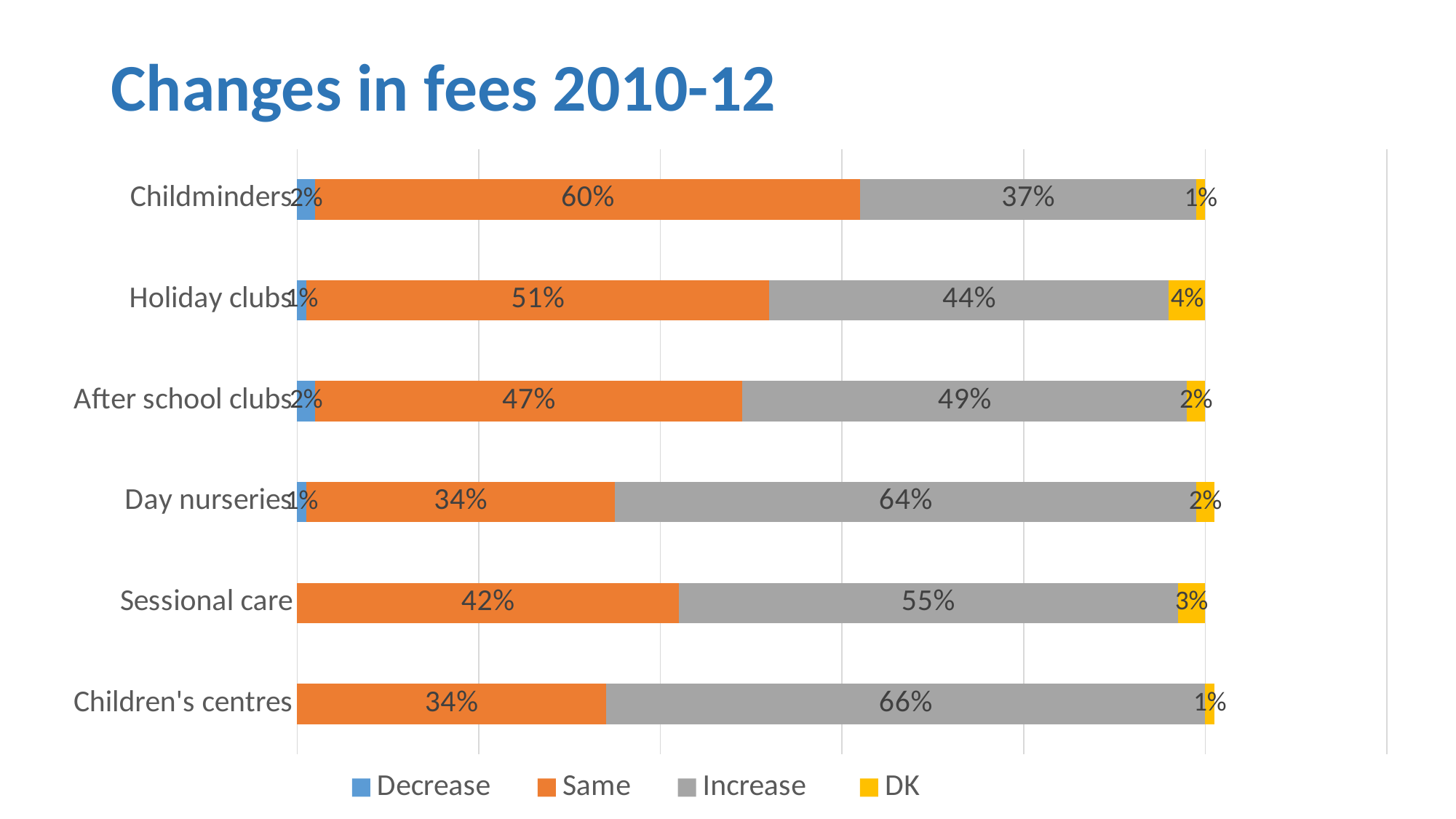
How many series does the legend list? 4 What is the total of the stacked bar for Childminders? 100% How many categories are shown on the chart? 6 What kind of chart is shown on the slide? Stacked bar chart What is the difference between the 'Increase' values for Children's centres and Childminders? 29% Which category has the highest 'Increase' value? Children's centres Which category has the lowest 'Same' value? Day nurseries and Children's centres (34%) Which is larger for After school clubs: the 'Same' value or the 'Increase' value? Increase What is the 'Same' value for Childminders? 60% What is the title of the chart? Changes in fees 2010-12 What is the 'Increase' value for Day nurseries? 64% What is the 'DK' value for Holiday clubs? 4%